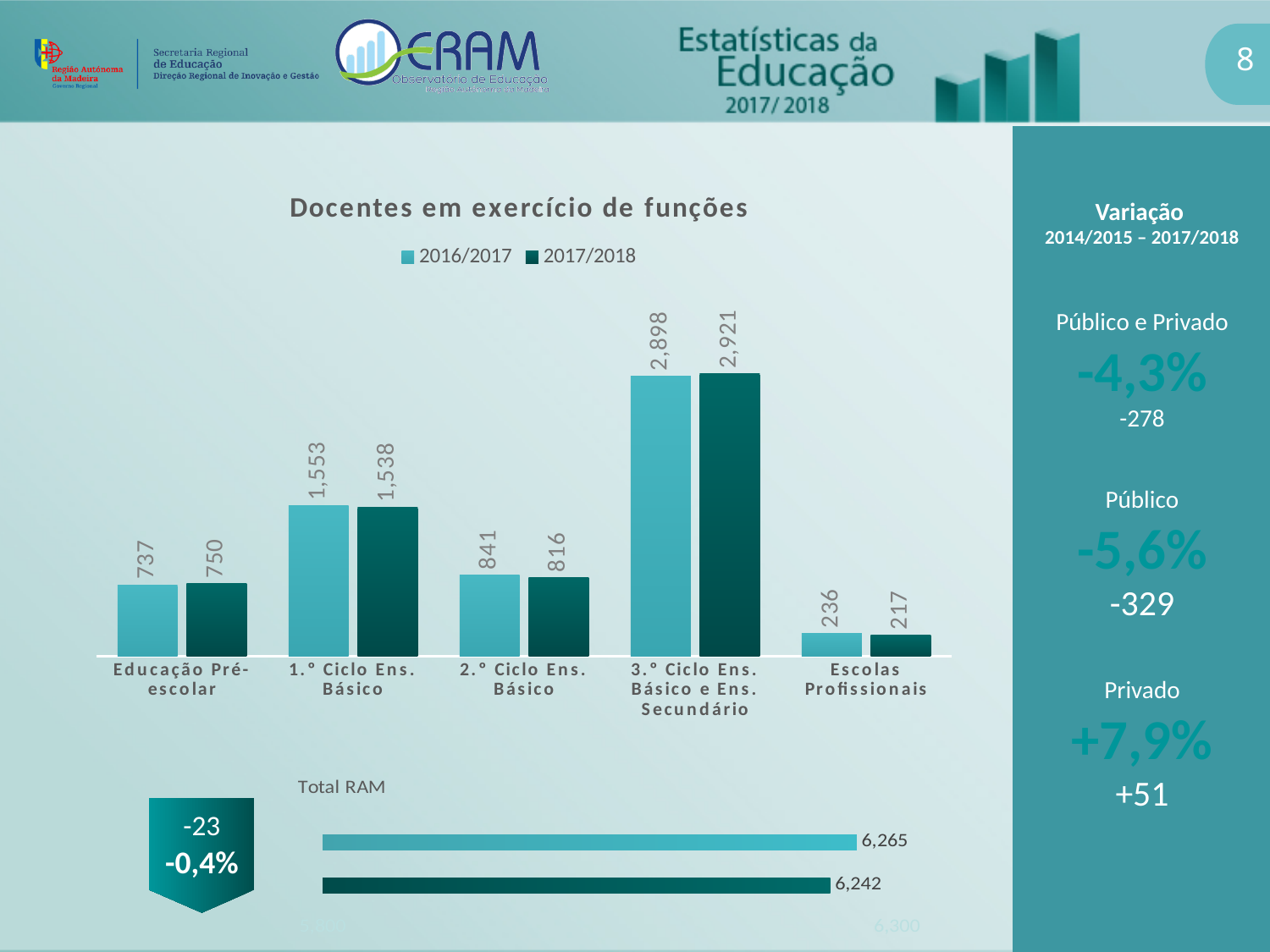
In the 'Total RAM' chart at the bottom of the slide, what is the difference between the two bars? 23 In the chart 'Docentes em exercício de funções', what is the difference between the 2016/2017 and 2017/2018 values for 2.º Ciclo Ens. Básico? 25 In the chart 'Docentes em exercício de funções', what is the value for Educação Pré-escolar in 2016/2017? 737 In the chart 'Docentes em exercício de funções', what is the value for Escolas Profissionais in 2017/2018? 217 How many categories are shown on the x axis of the chart 'Docentes em exercício de funções'? 5 What kind of chart is 'Docentes em exercício de funções'? Bar chart In the chart 'Docentes em exercício de funções', what is the value for 3.º Ciclo Ens. Básico e Ens. Secundário in 2017/2018? 2,921 In the 'Total RAM' chart at the bottom of the slide, what is the value of the 2016/2017 bar? 6,265 In the chart 'Docentes em exercício de funções', which category has the highest value in 2016/2017? 3.º Ciclo Ens. Básico e Ens. Secundário In the chart 'Docentes em exercício de funções', which category has the lowest value in 2017/2018? Escolas Profissionais In the chart 'Docentes em exercício de funções', which is larger for 1.º Ciclo Ens. Básico: the 2016/2017 value or the 2017/2018 value? 2016/2017 How many series does the legend of the chart 'Docentes em exercício de funções' list? 2